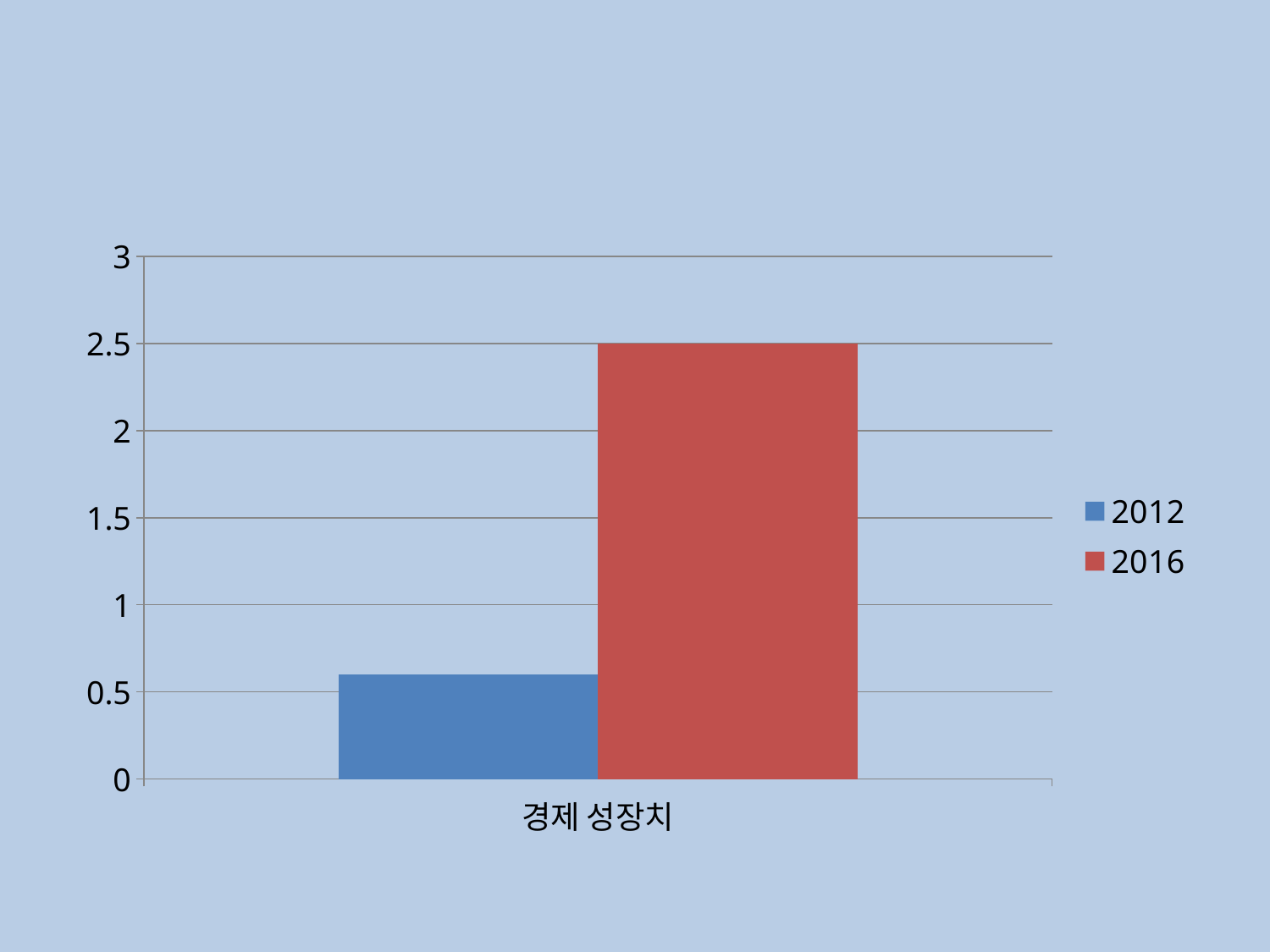
Is the value of the 2012 bar for 경제 성장치 greater or less than 1? less What kind of chart is shown on the slide? bar chart What colour is the bar for the 2016 series? red What is the category label shown on the x axis? 경제 성장치 Which series has the larger value for 경제 성장치, 2012 or 2016? 2016 How many categories are shown on the x axis? 1 Is the value of the 2012 bar for 경제 성장치 greater or less than 0.5? greater Which series has the highest bar in the chart? 2016 Does the value for 경제 성장치 rise or fall from 2012 to 2016? rise Which series has the lowest bar in the chart? 2012 How many series does the legend list? 2 What is the value of the 2016 bar for 경제 성장치? 2.5